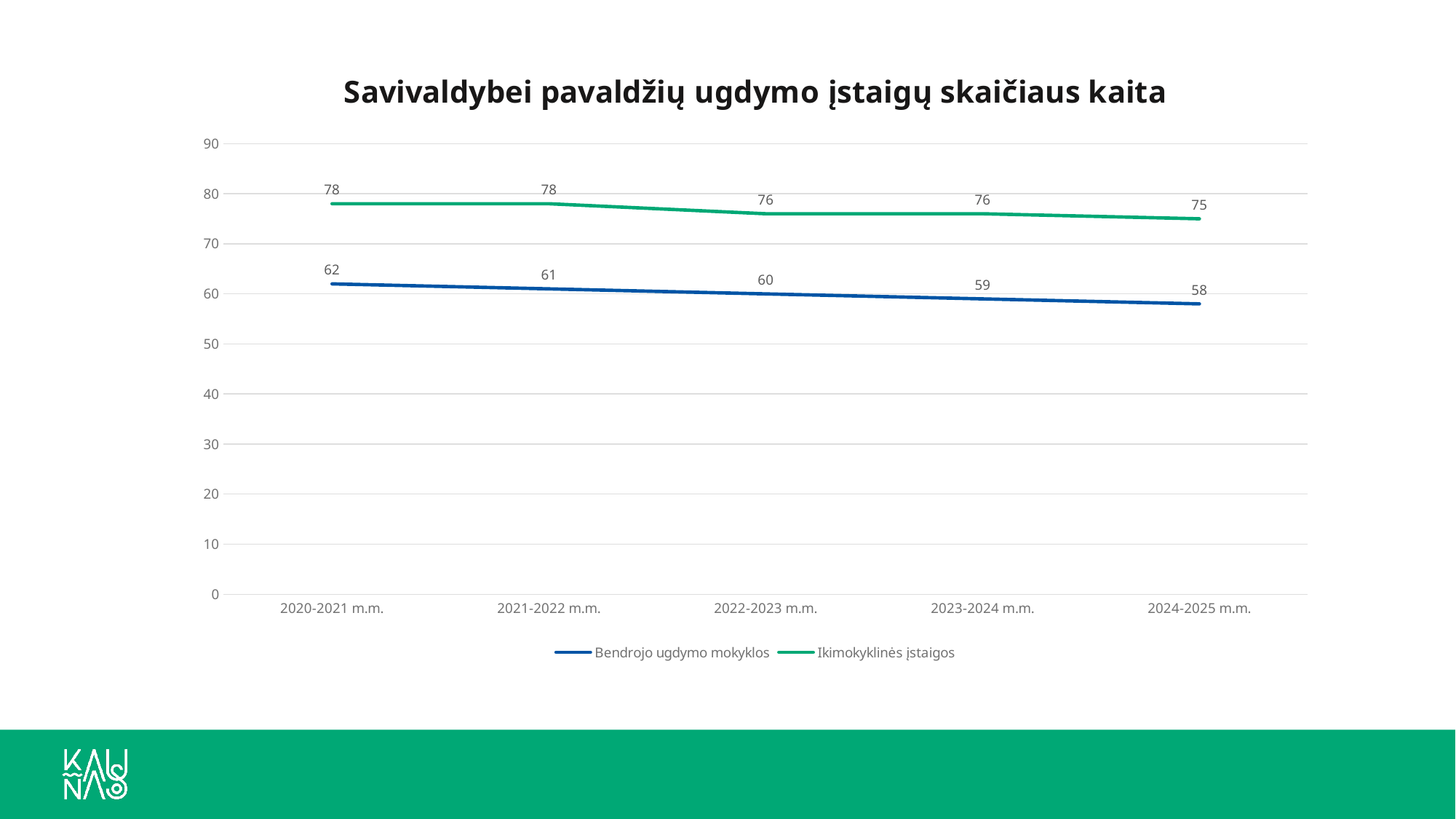
What is the value for Bendrojo ugdymo mokyklos in 2020-2021 m.m.? 62 What is the difference between Ikimokyklinės įstaigos and Bendrojo ugdymo mokyklos in 2021-2022 m.m.? 17 What is the value for Ikimokyklinės įstaigos in 2024-2025 m.m.? 75 In which school year is the value for Bendrojo ugdymo mokyklos lowest? 2024-2025 m.m. What is the value for Bendrojo ugdymo mokyklos in 2023-2024 m.m.? 59 What kind of chart is shown on the slide? Line chart How many school years are shown on the x axis? 5 Do the values for Ikimokyklinės įstaigos rise or fall from 2020-2021 m.m. to 2024-2025 m.m.? Fall Which series has the higher value in 2023-2024 m.m., Bendrojo ugdymo mokyklos or Ikimokyklinės įstaigos? Ikimokyklinės įstaigos How many series does the legend list? 2 What is the value for Ikimokyklinės įstaigos in 2022-2023 m.m.? 76 By how much did the value for Bendrojo ugdymo mokyklos change from 2020-2021 m.m. to 2024-2025 m.m.? 4